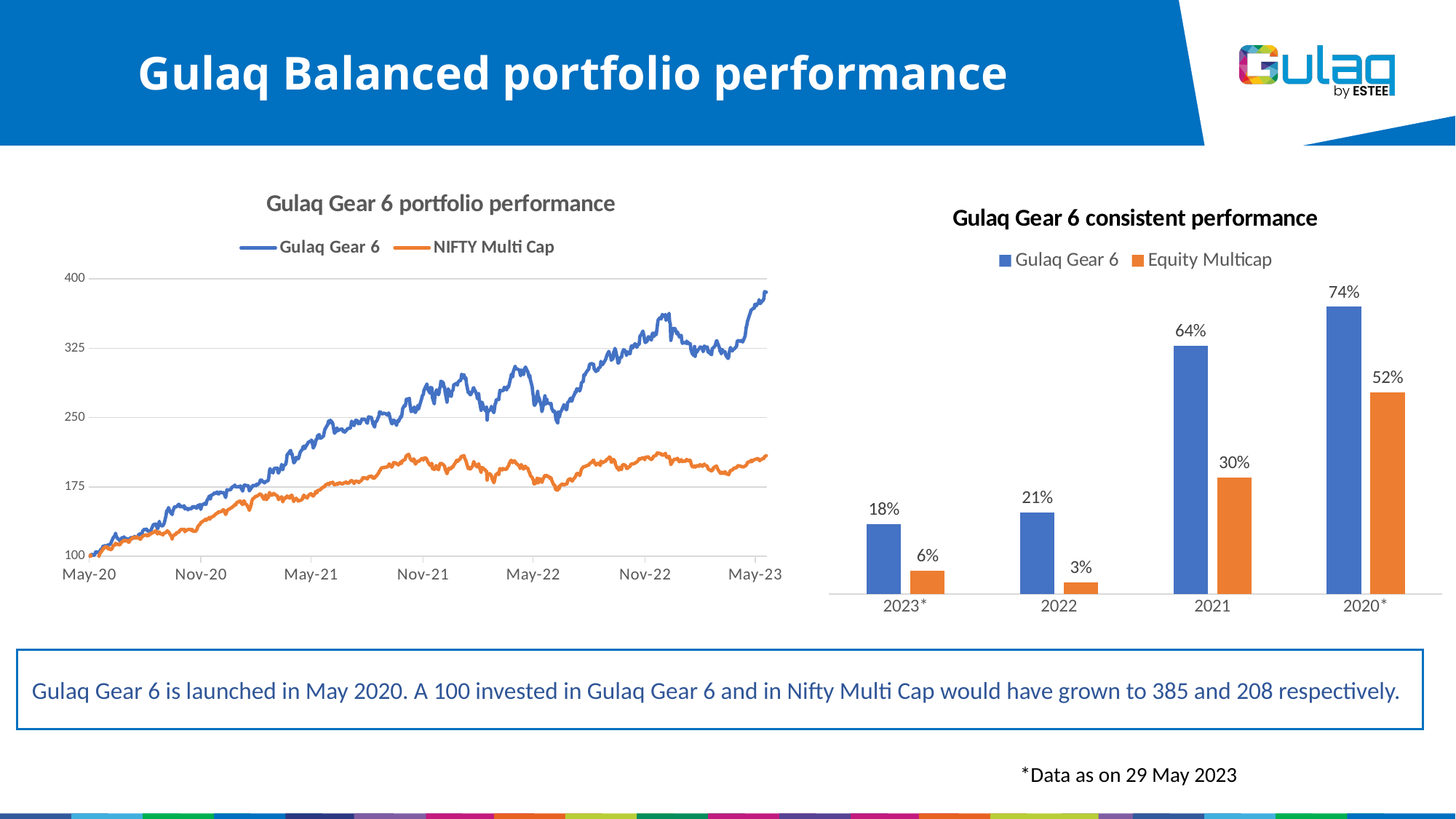
How many series does the legend of the 'Gulaq Gear 6 consistent performance' chart list? 2 In the 'Gulaq Gear 6 consistent performance' chart, what is the difference between Gulaq Gear 6 and Equity Multicap in 2021? 34% In the 'Gulaq Gear 6 consistent performance' chart, which is larger in 2023*: Gulaq Gear 6 or Equity Multicap? Gulaq Gear 6 In the 'Gulaq Gear 6 consistent performance' chart, which year has the highest Gulaq Gear 6 value? 2020* In the 'Gulaq Gear 6 consistent performance' chart, what is the value for Equity Multicap in 2020*? 52% In the 'Gulaq Gear 6 consistent performance' chart, which year has the lowest Equity Multicap value? 2022 What kind of chart is the 'Gulaq Gear 6 portfolio performance' chart on the left? Line chart In the 'Gulaq Gear 6 portfolio performance' chart, which series is shown in orange? NIFTY Multi Cap In the 'Gulaq Gear 6 consistent performance' chart, what is the value for Equity Multicap in 2022? 3% In the 'Gulaq Gear 6 consistent performance' chart, what is the value for Gulaq Gear 6 in 2021? 64% In the 'Gulaq Gear 6 portfolio performance' chart, is the Gulaq Gear 6 value at May-23 greater or less than 325? greater How many year categories are shown on the x axis of the 'Gulaq Gear 6 consistent performance' chart? 4